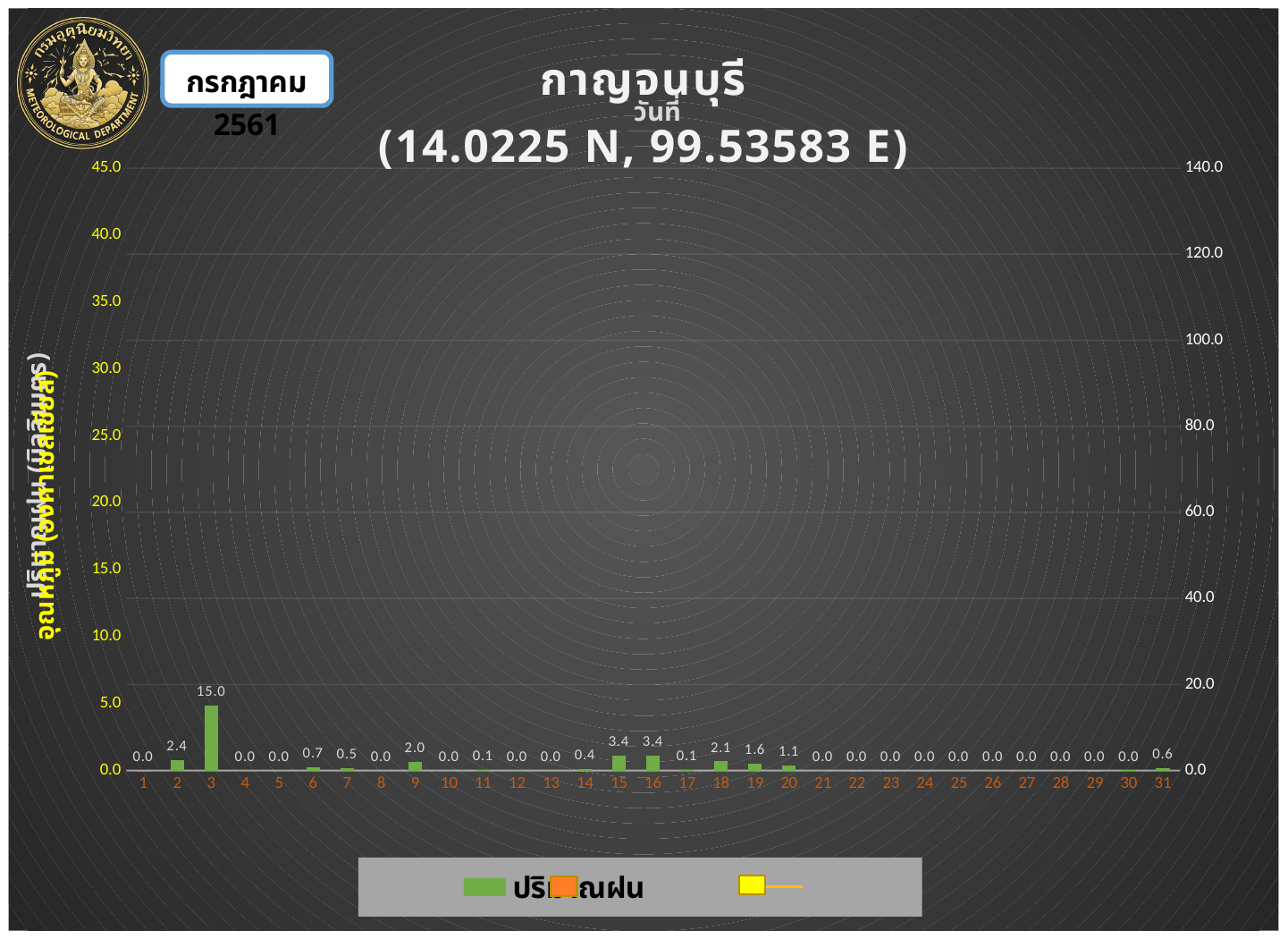
What is the rainfall value shown for day 3? 15.0 What is the difference between the values for day 3 and day 2? 12.6 What is the difference between the values for day 18 and day 20? 1.0 What are the coordinates shown in the chart title? 14.0225 N, 99.53583 E What is the value shown for day 19? 1.6 Which is larger, the value for day 9 or the value for day 18? day 18 What is the value shown for day 15? 3.4 What is the value shown for day 31? 0.6 Which day has the highest value? 3 How many days are shown on the x axis? 31 What kind of chart is shown on the slide? bar chart